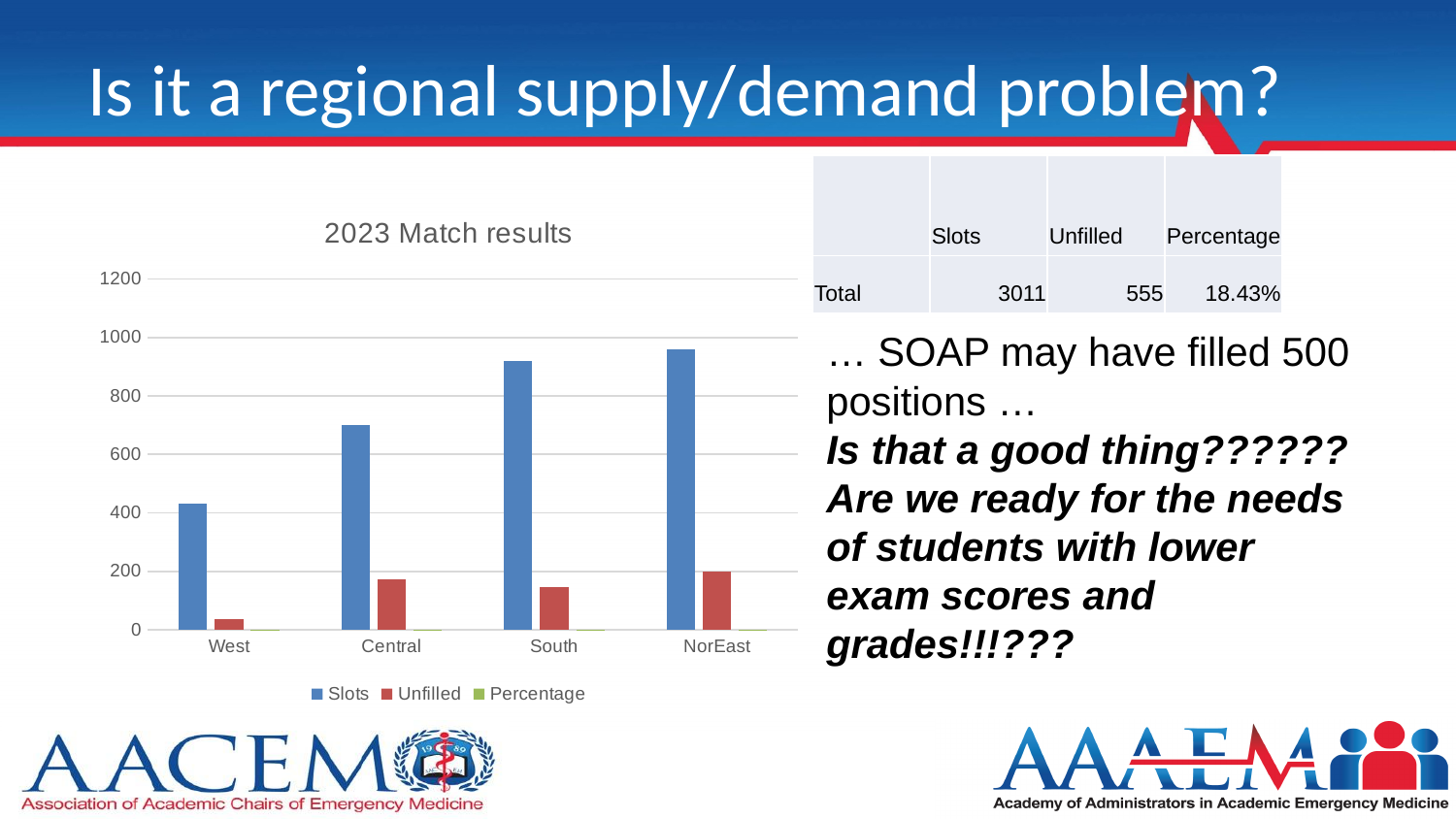
Is the Slots value for South greater or less than 800? greater Which region has the lowest Unfilled value? West What is the title of the chart? 2023 Match results How many regions are shown on the x axis of the chart? 4 Which region has the lowest Slots value? West Is the Slots value for West greater or less than 400? greater Is the Slots value for Central greater or less than 800? less Which is larger, the Slots value for South or the Slots value for Central? South How many series does the chart legend list? 3 What kind of chart is shown on the slide? bar chart Do the Slots values rise or fall moving from West to NorEast along the x axis? rise